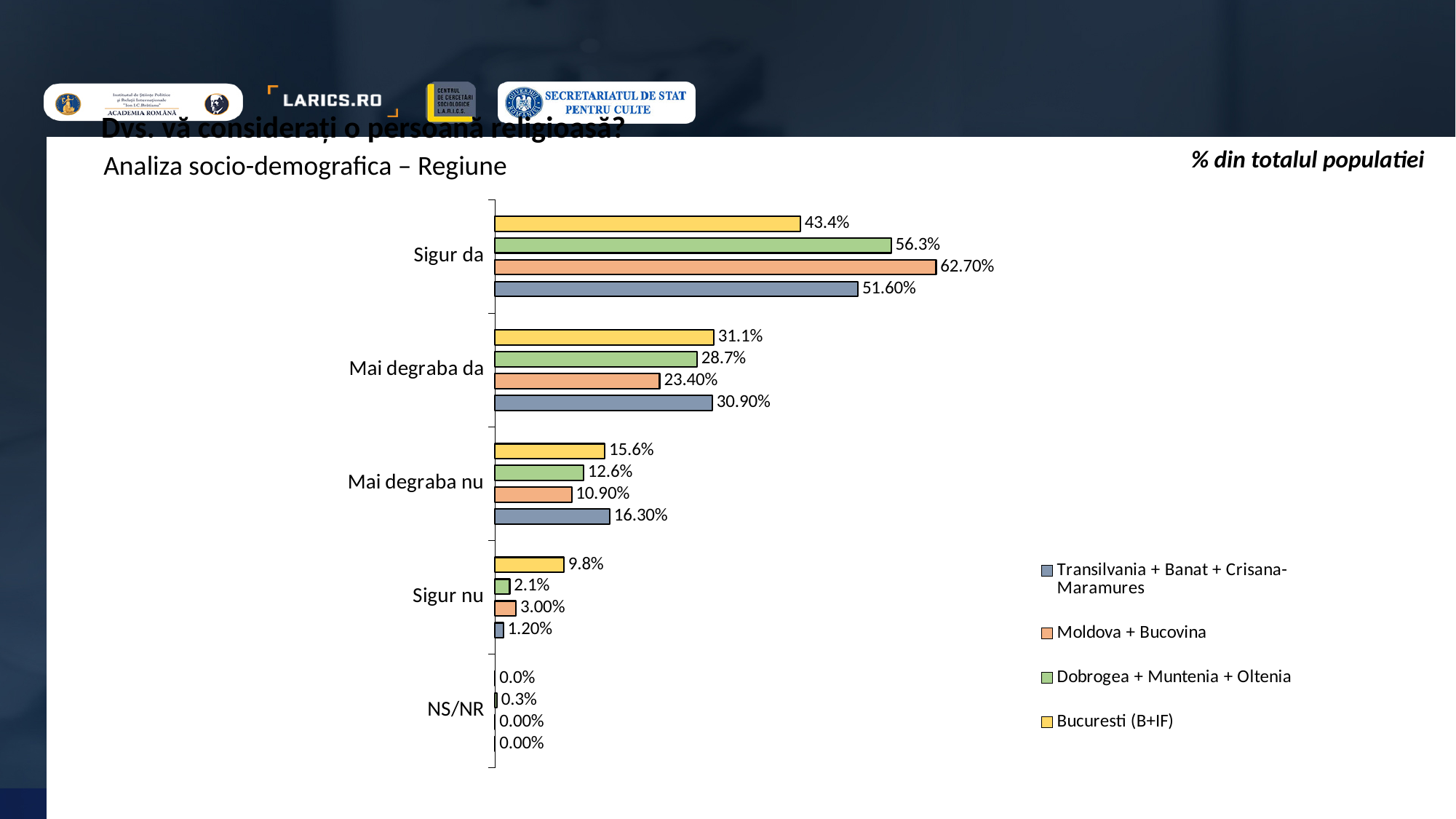
What is the value for Transilvania + Banat + Crisana-Maramures in the 'Mai degraba nu' category? 16.30% Which region has the highest value in the 'Sigur da' category? Moldova + Bucovina In the 'Mai degraba da' category, which is larger: the value for Bucuresti (B+IF) or the value for Moldova + Bucovina? Bucuresti (B+IF) What kind of chart is shown on the slide? Bar chart How many series does the legend list? 4 What is the subtitle of the chart below the main question? Analiza socio-demografica – Regiune What is the difference between the Dobrogea + Muntenia + Oltenia and Bucuresti (B+IF) values in the 'Sigur da' category? 12.9% What is the value for Bucuresti (B+IF) in the 'Sigur nu' category? 9.8% Which region has the lowest value in the 'Sigur nu' category? Transilvania + Banat + Crisana-Maramures What is the value for Dobrogea + Muntenia + Oltenia in the 'NS/NR' category? 0.3% What is the value for Moldova + Bucovina in the 'Sigur da' category? 62.70% How many response categories are shown on the chart? 5